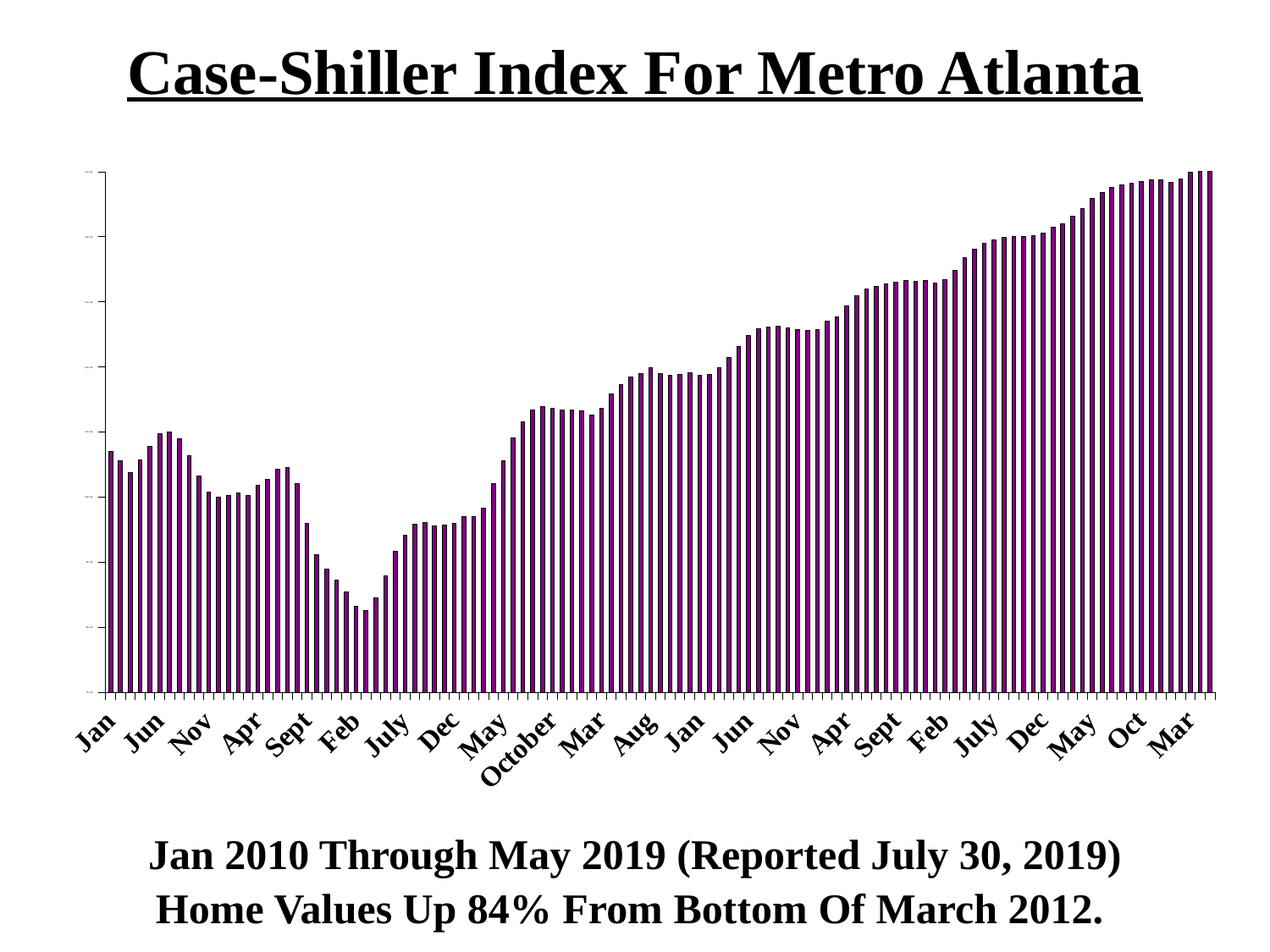
Overall, do the bars rise or fall from the left of the x axis to the right? rise Is the bar at the "Oct" label higher or lower than the bar at the "October" label? higher Is the bar at the first "Jun" label higher or lower than the bar at the second "Jun" label? lower Is the bar at the "Feb" label higher or lower than the bar at the "Dec" label that follows "July"? lower According to the slide text, in which month and year did home values bottom out? March 2012 Between the first "Jan" label and the "Feb" label, do the bars generally rise or fall? fall What is the title of the chart? Case-Shiller Index For Metro Atlanta Which end of the x axis has the tallest bars, the left end or the right end? right end What kind of chart is shown on the slide? bar chart